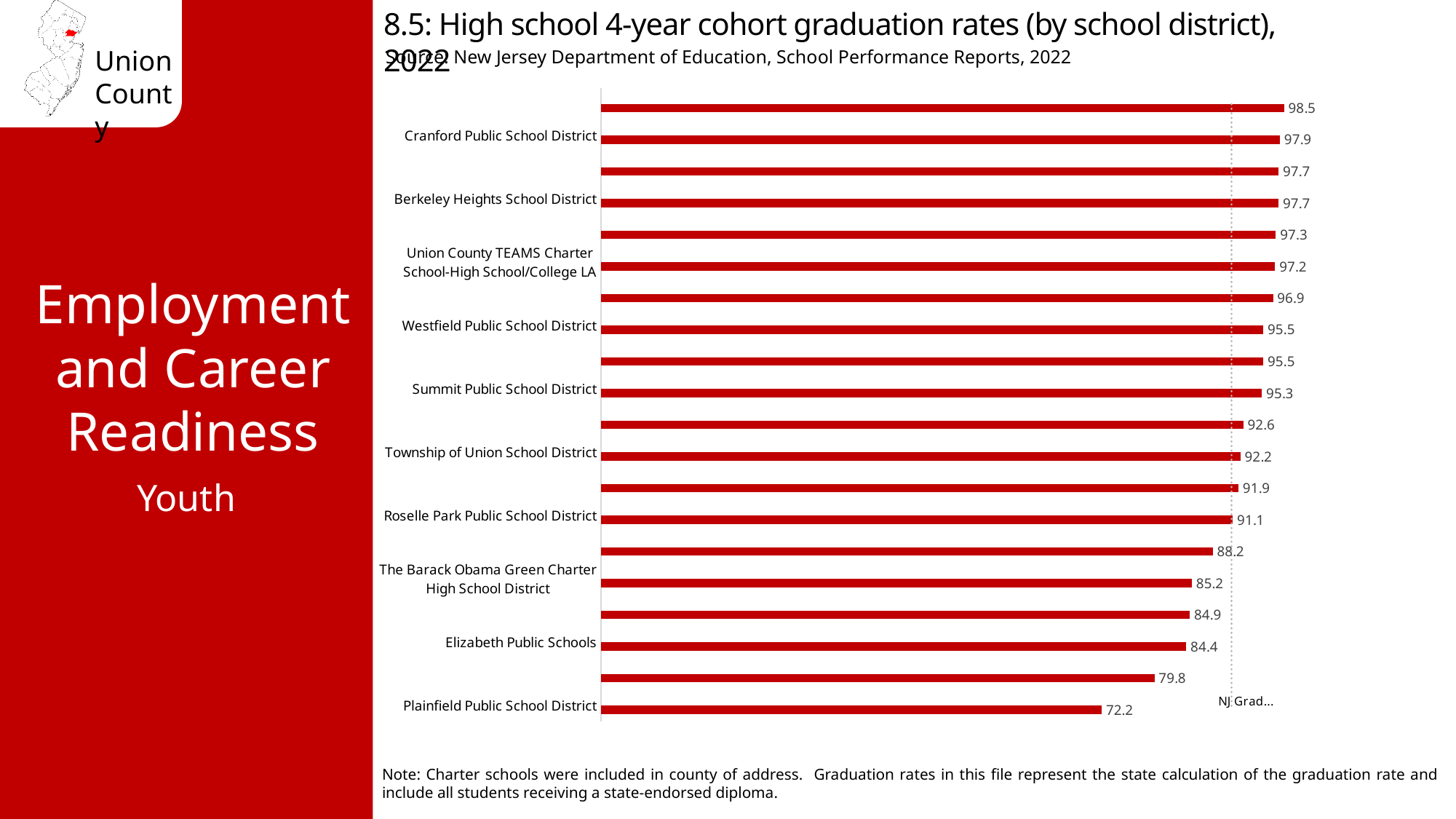
What type of chart is used to show the graduation rates? Bar chart How many bars are plotted on the chart? 20 What is the graduation rate for Westfield Public School District? 95.5 What is the 4-year cohort graduation rate for Cranford Public School District? 97.9 What is the difference between the graduation rates of Cranford Public School District and Plainfield Public School District? 25.7 What is the source cited for the chart data? New Jersey Department of Education, School Performance Reports, 2022 What is the graduation rate for The Barack Obama Green Charter High School District? 85.2 What is the graduation rate shown for Plainfield Public School District? 72.2 Which has a higher graduation rate, Summit Public School District or Township of Union School District? Summit Public School District What is the graduation rate for Elizabeth Public Schools? 84.4 Which labeled school district has the lowest graduation rate on the chart? Plainfield Public School District What is the highest graduation rate value shown on the chart? 98.5